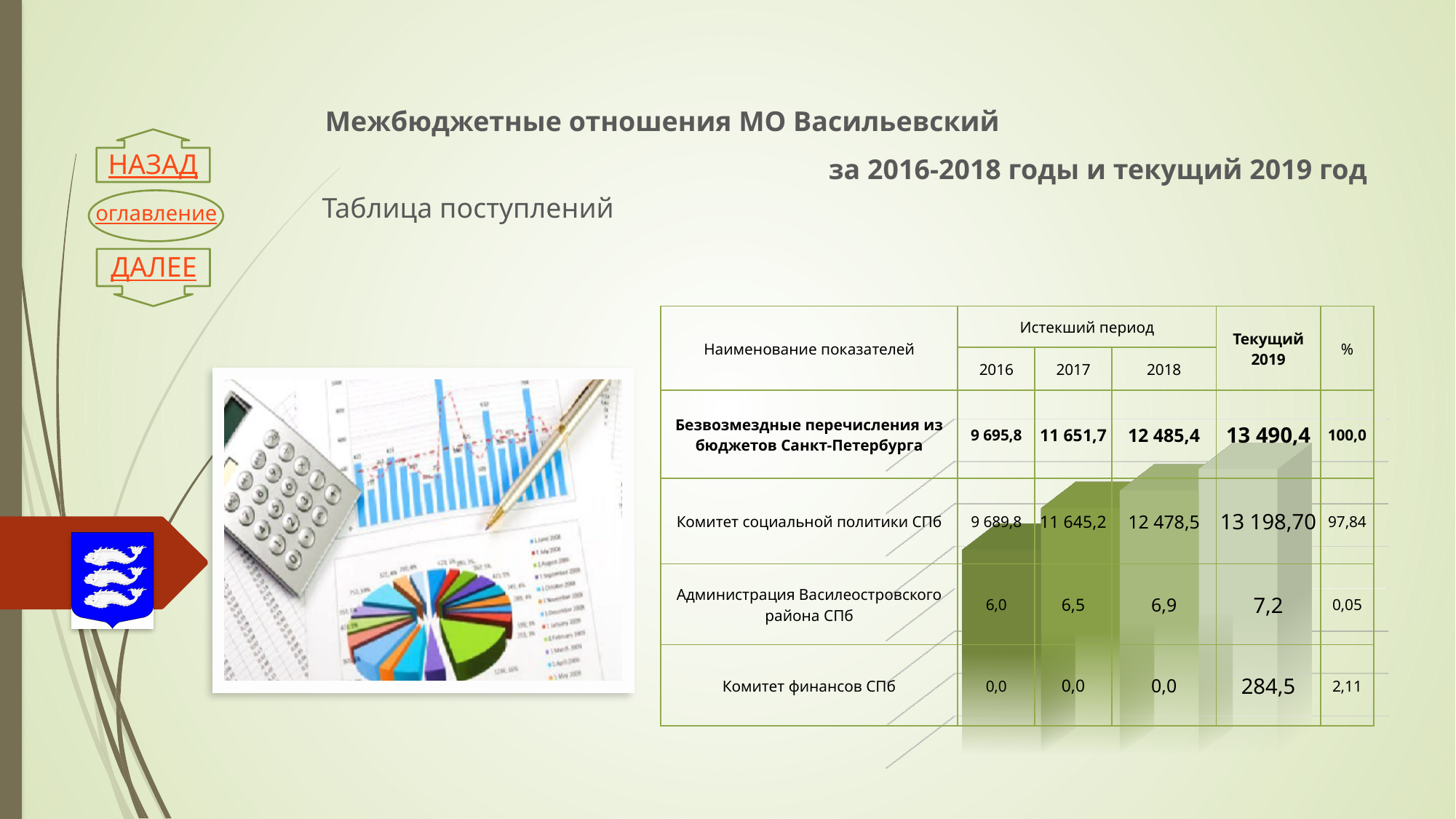
Is the bar for 2017 taller or shorter than the bar for 2018 in the chart behind the table? shorter What kind of chart is drawn behind the table on the right of the slide? bar chart What percentage is shown for 'Комитет социальной политики СПб' in the table? 97,84 What colour are the bars in the chart behind the table? green What is the value of 'Безвозмездные перечисления из бюджетов Санкт-Петербурга' for the current year 2019 in the table? 13 490,4 Do the bars in the chart behind the table rise or fall from left to right? rise What is the value for 'Комитет финансов СПб' in 2019 in the table? 284,5 How many bars does the chart behind the table show? 4 Which year column has the tallest bar in the chart behind the table? 2019 What is the value of 'Безвозмездные перечисления из бюджетов Санкт-Петербурга' for 2016 in the table? 9 695,8 What is the title of the table above the chart? Таблица поступлений Which year column has the shortest bar in the chart behind the table? 2016